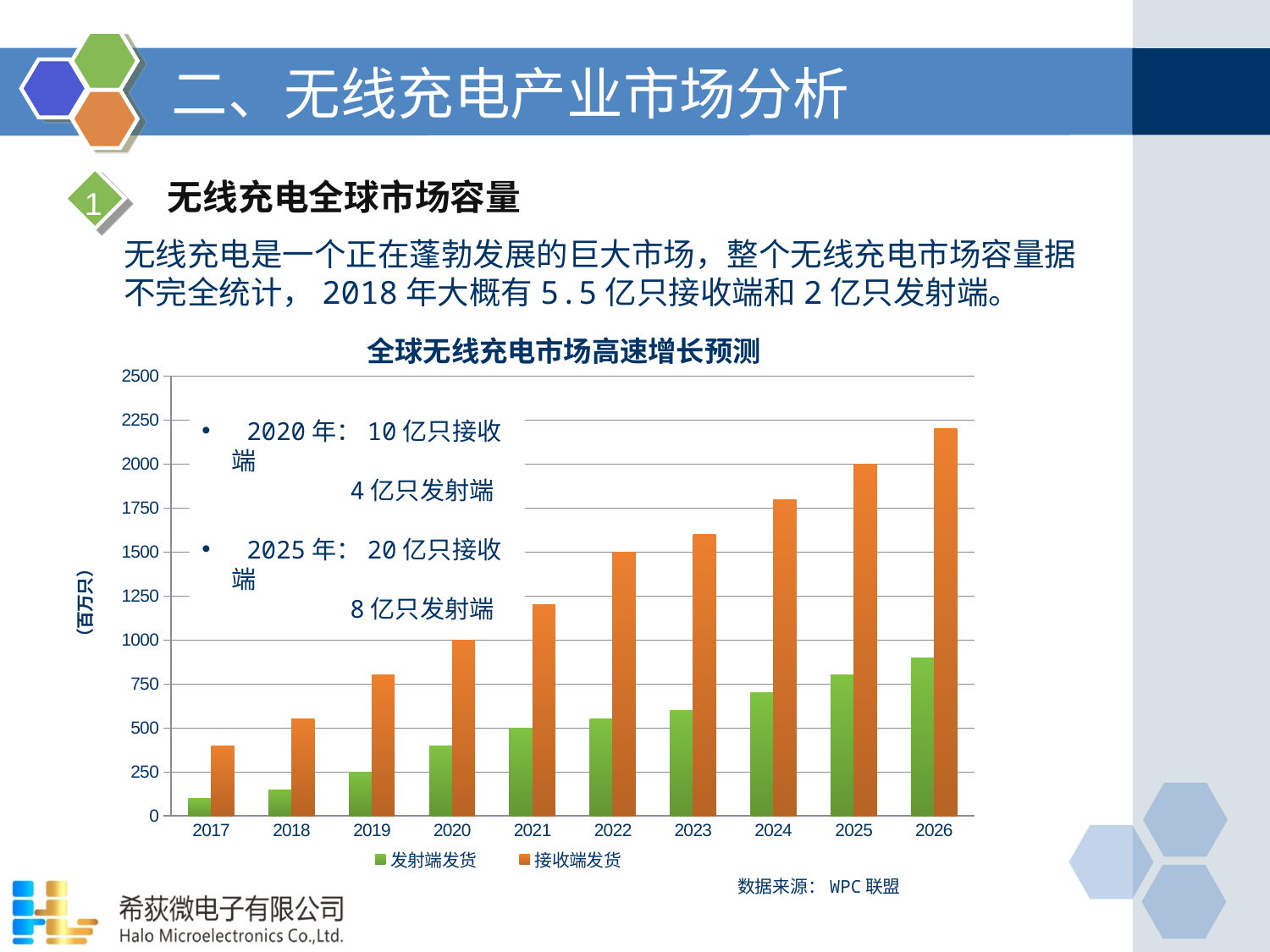
How many years are shown on the x axis of the chart? 10 How many series does the legend of the chart list? 2 What is the title of the chart? 全球无线充电市场高速增长预测 Which is larger in 2023, 发射端发货 or 接收端发货? 接收端发货 Do the 接收端发货 values rise or fall from 2017 to 2026? rise What is the 接收端发货 value for 2020? 1000 Which year has the highest 接收端发货 value? 2026 Is the 接收端发货 value for 2026 greater or less than 2000? greater What is the 发射端发货 value for 2021? 500 Which year has the lowest 发射端发货 value? 2017 What is the 接收端发货 value for 2025? 2000 What kind of chart is shown on the slide? bar chart